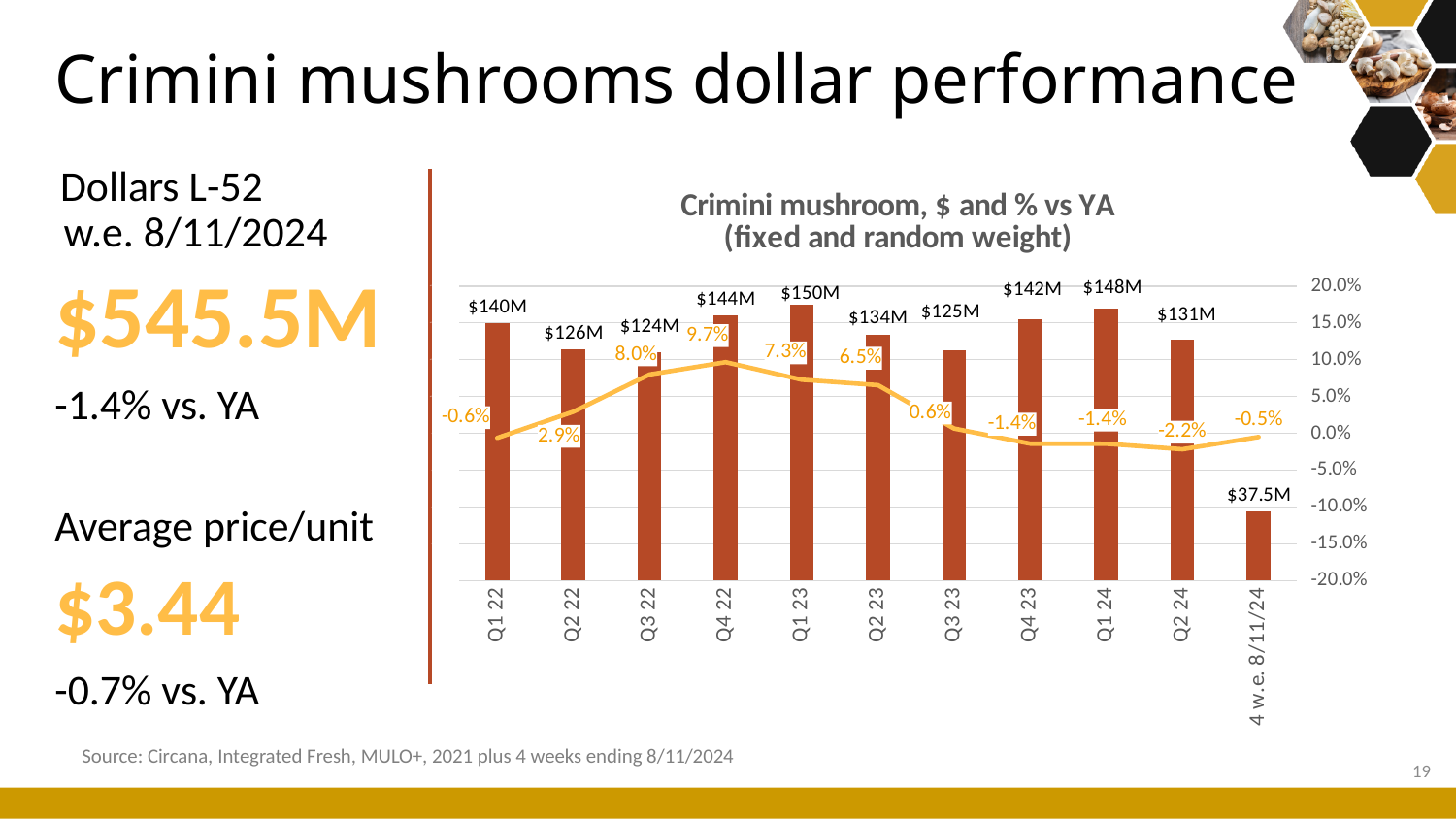
What is the dollar value for Q1 23? $150M Which period has the highest dollar value? Q1 23 Which has a larger dollar value, Q4 22 or Q4 23? Q4 22 How many periods are shown on the x axis? 11 What is the difference in dollar value between Q1 23 and Q1 22? $10M What kind of chart is this? Combined bar and line chart Does the % vs YA line rise or fall from Q4 22 to Q2 24? Fall Which period has the highest % vs YA value? Q4 22 What is the dollar value for the 4 w.e. 8/11/24 period? $37.5M Which period has the lowest dollar value? 4 w.e. 8/11/24 What is the % vs YA value for Q4 22? 9.7% What is the % vs YA value for Q2 24? -2.2%